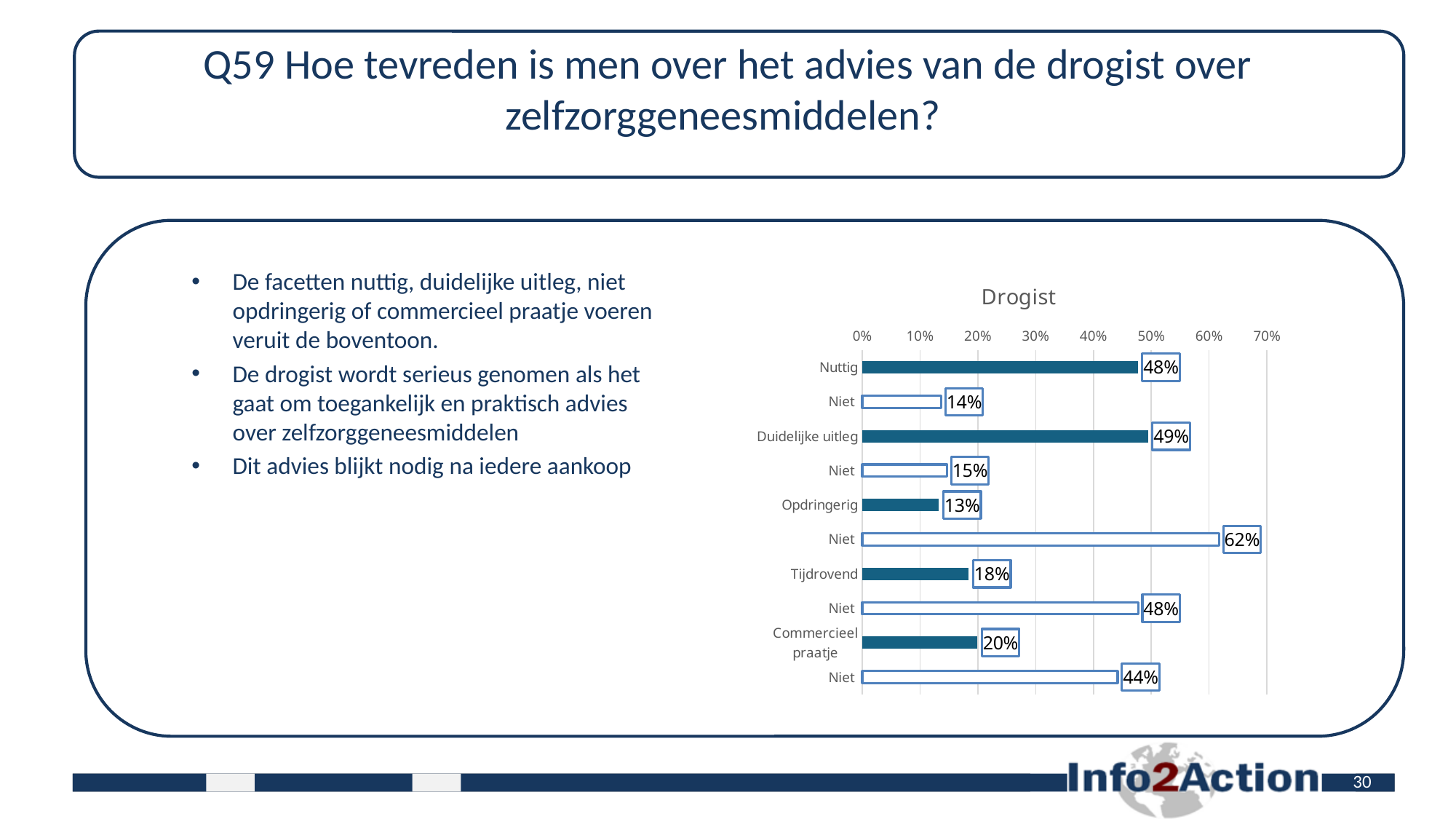
What is the value for Commercieel praatje in the Drogist chart? 20% What is the value for Tijdrovend in the Drogist chart? 18% Which is larger in the Drogist chart: Tijdrovend or Commercieel praatje? Commercieel praatje How many bars are shown in the Drogist chart? 10 Which bar has the lowest value in the Drogist chart? Opdringerig What is the value for Nuttig in the Drogist chart? 48% What is the difference between the 'Niet' bar below Opdringerig (62%) and Opdringerig (13%) in the Drogist chart? 49% What is the value of the 'Niet' bar directly below Opdringerig in the Drogist chart? 62% Which bar has the highest value in the Drogist chart? Niet (below Opdringerig) What is the value for Duidelijke uitleg in the Drogist chart? 49% What type of chart is the Drogist chart? Bar chart What is the value for Opdringerig in the Drogist chart? 13%